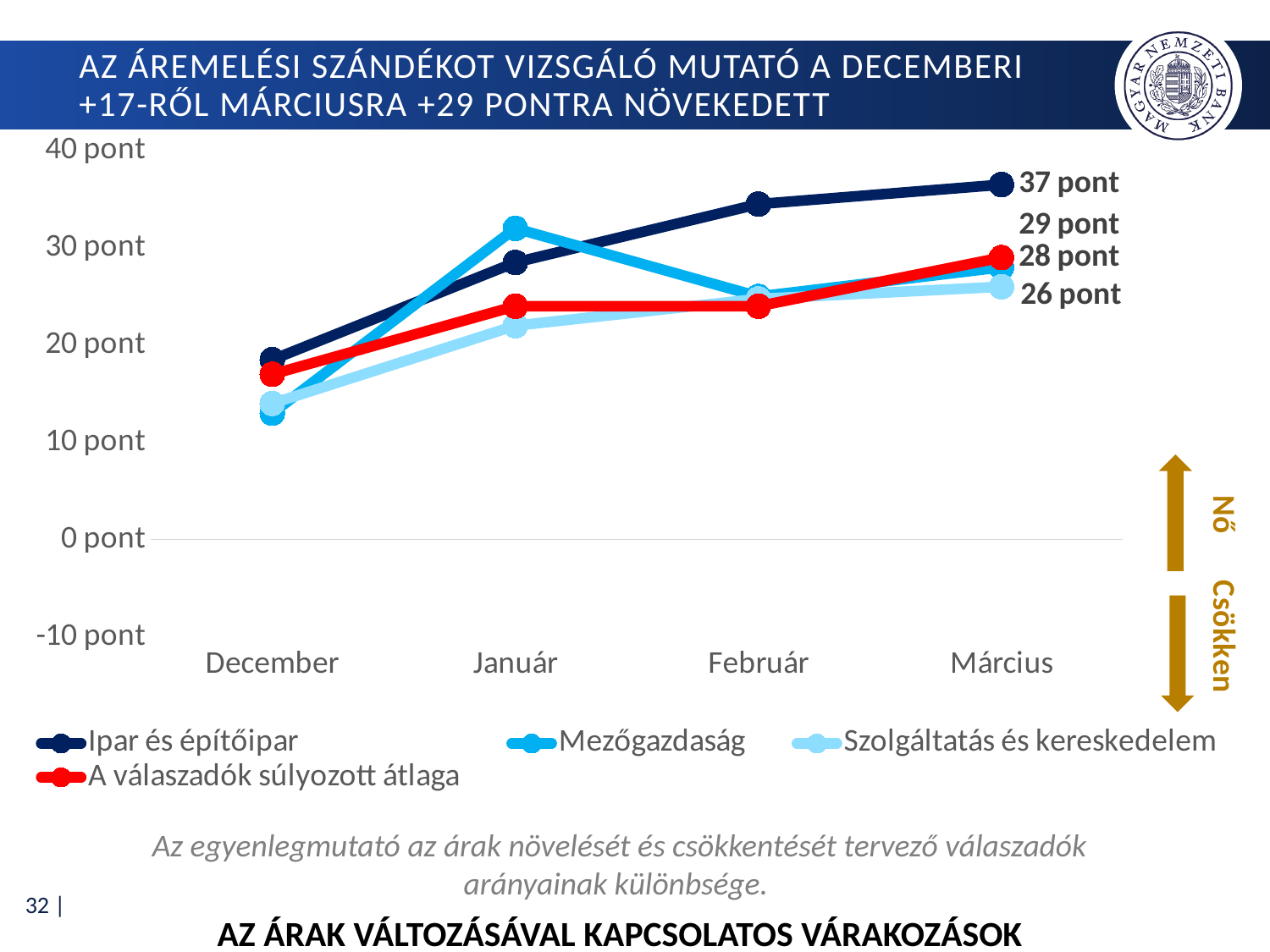
Does the Ipar és építőipar series rise or fall from December to Március? rise What kind of chart is shown on the slide? line chart Which series has the highest value in Március? Ipar és építőipar What is the value for A válaszadók súlyozott átlaga in Március? 29 pont How many months are shown on the x axis? 4 Is the value for Mezőgazdaság in Január greater or less than 30 pont? greater What is the value for Szolgáltatás és kereskedelem in Március? 26 pont Is the value for Szolgáltatás és kereskedelem in December greater or less than 20 pont? less Which series has the lowest value in Március? Szolgáltatás és kereskedelem How many series does the legend list? 4 What is the value for Ipar és építőipar in Március? 37 pont What is the difference between Ipar és építőipar and Szolgáltatás és kereskedelem in Március? 11 pont